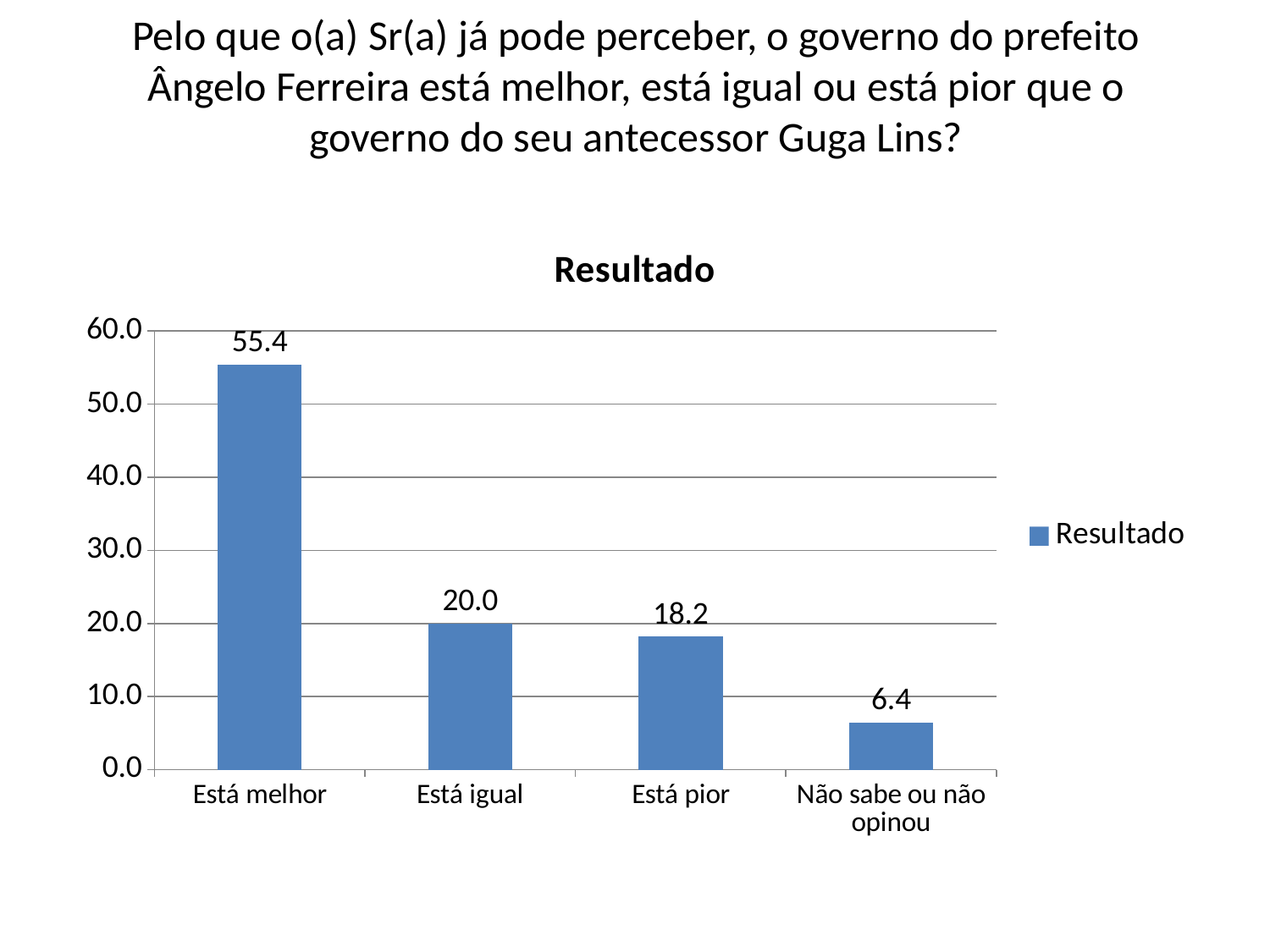
What is the title of the chart? Resultado What is the difference between the values for "Está melhor" and "Está igual"? 35.4 What kind of chart is shown on the slide? Bar chart Which category has the lowest value? Não sabe ou não opinou What is the value for "Está pior"? 18.2 Which category has the highest value? Está melhor What is the value for "Está igual"? 20.0 What is the difference between the values for "Está pior" and "Não sabe ou não opinou"? 11.8 What is the value for "Está melhor"? 55.4 How many categories are shown on the x axis? 4 What is the value for "Não sabe ou não opinou"? 6.4 Which is larger, the value for "Está igual" or the value for "Está pior"? Está igual